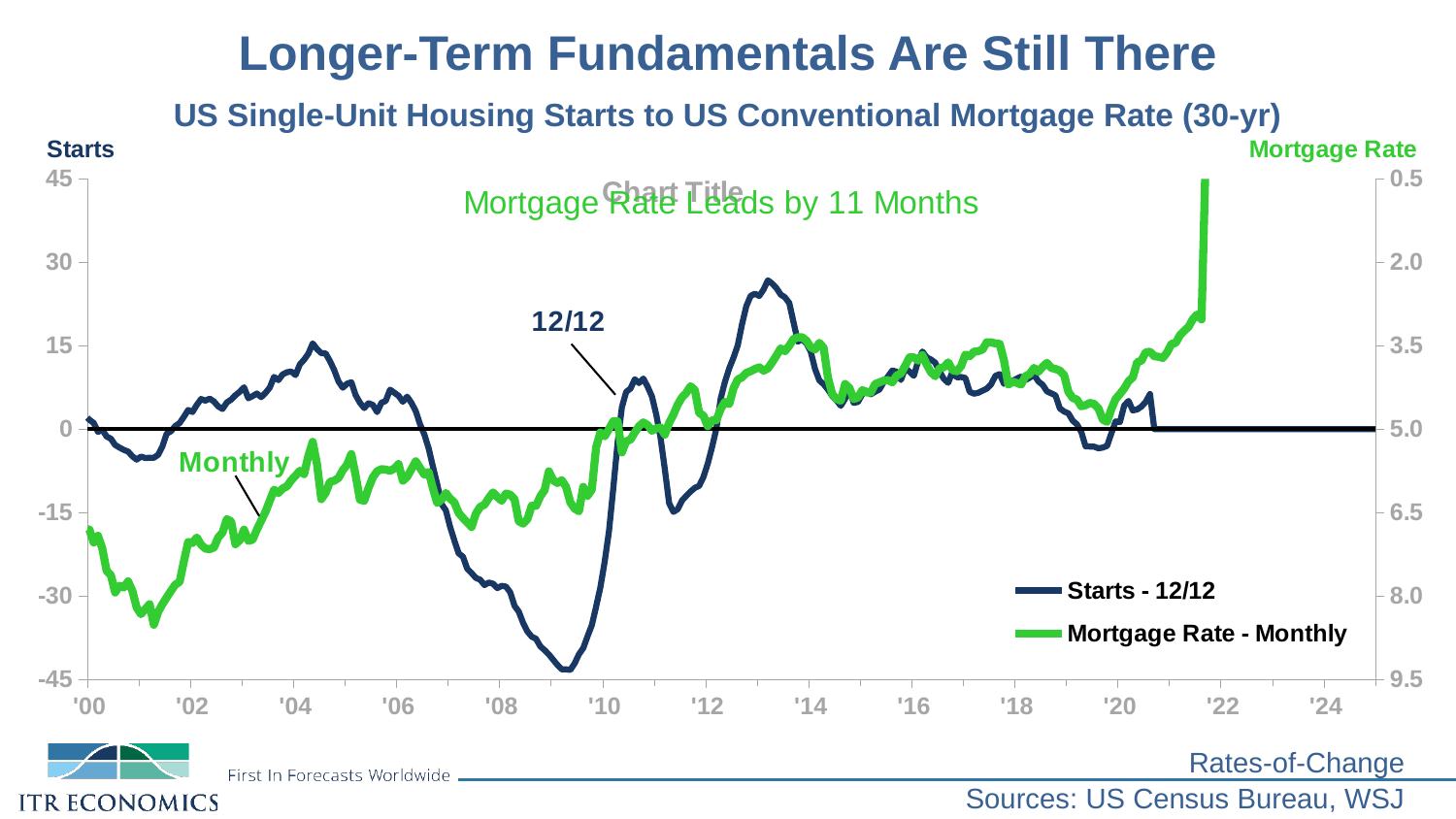
Is the value of Starts - 12/12 around '13 greater or less than 15? greater What does the annotation at the top of the chart say about the lead time of the mortgage rate? Mortgage Rate Leads by 11 Months What kind of chart is shown on the slide? line chart Which series is drawn in green? Mortgage Rate - Monthly How many year labels are shown on the x axis? 13 Is the value of Starts - 12/12 around '09 greater or less than -30? less Does Starts - 12/12 rise or fall between '07 and '09? fall Around which year does Starts - 12/12 reach its lowest point? '09 Around which year does Starts - 12/12 reach its highest point? '13 Is the Mortgage Rate - Monthly value around '01 greater or less than 6.5 on the right axis? greater How many series does the legend list? 2